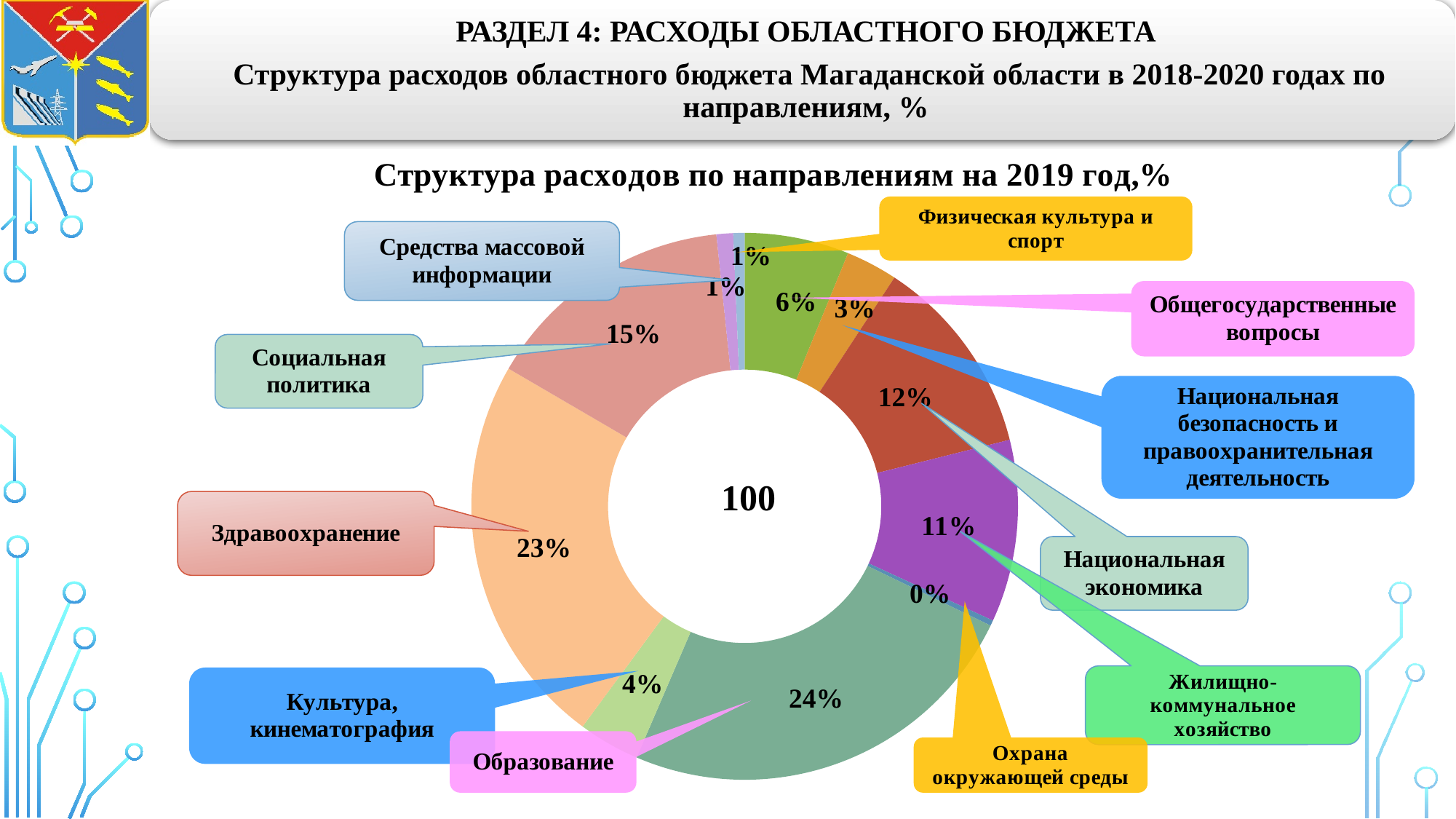
What is the difference between the shares of Образование and Социальная политика? 9% What share of expenditures goes to Социальная политика? 15% What share of expenditures goes to Здравоохранение? 23% What kind of chart is shown on the slide? Pie (doughnut) chart Which direction has the largest share of expenditures? Образование Which direction has the smallest share of expenditures? Охрана окружающей среды How many expenditure directions are labelled on the chart? 11 Which is larger: the share of Здравоохранение or the share of Национальная экономика? Здравоохранение What share of expenditures goes to Культура, кинематография? 4% What share of expenditures goes to Образование? 24% What is the title of the chart? Структура расходов по направлениям на 2019 год,% What share of expenditures goes to Охрана окружающей среды? 0%